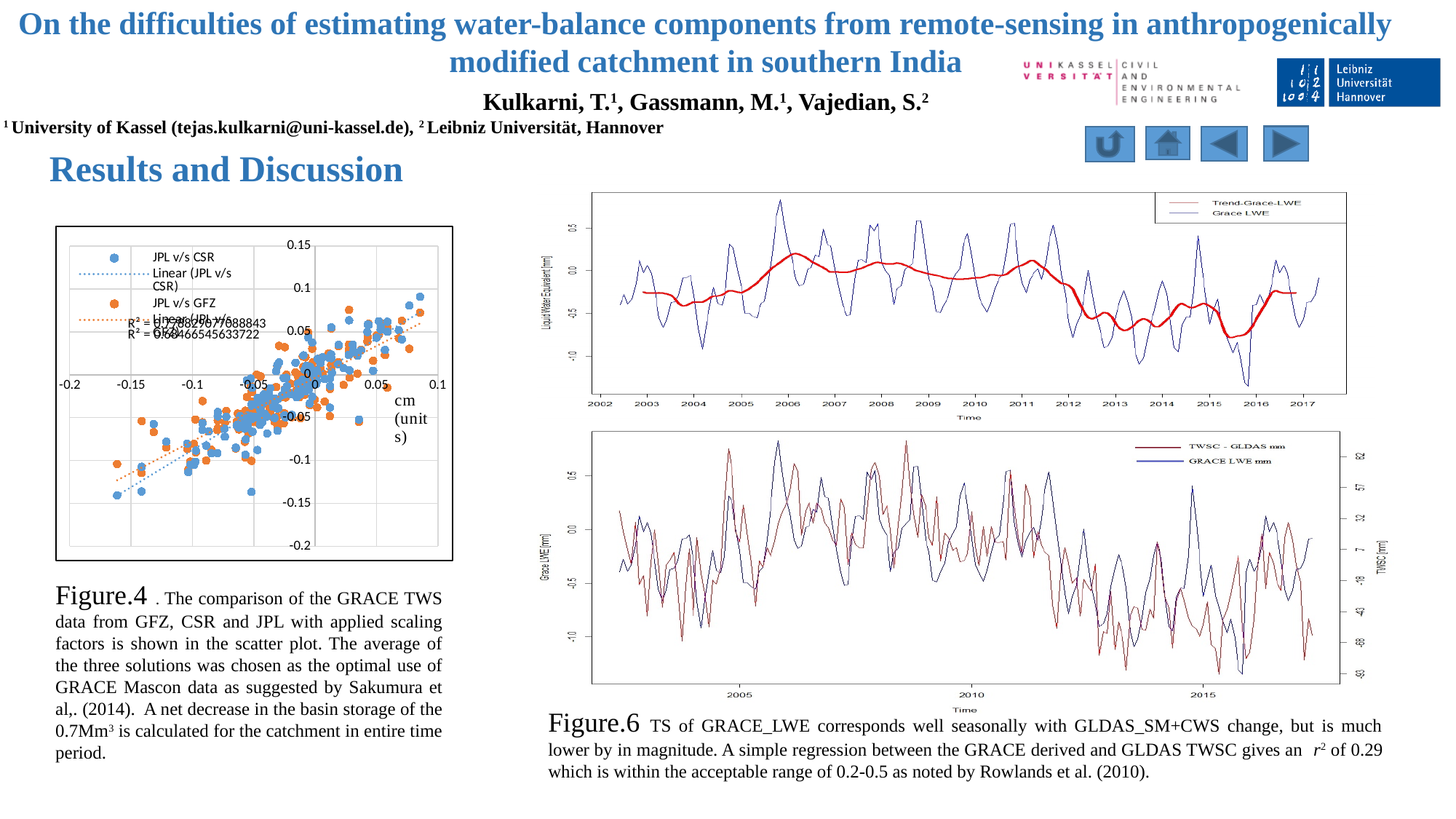
What are the two legend entries of the bottom right chart? TWSC - GLDAS mm and GRACE LWE mm In the top right chart, does the red Trend-Grace-LWE line rise or fall between 2006 and 2015? fall How many series does the legend of the bottom right chart list? 2 In the top right chart, is the lowest value of the Grace LWE series (around 2016) greater or less than -1.0? less In the scatter chart of Figure 4, do the points generally rise or fall as the x value increases? rise What kind of chart is Figure 4 on the left of the slide? scatter chart How many series does the legend of the top right chart list? 2 How many entries does the legend of the scatter chart in Figure 4 list? 4 In the top right chart, what is the first year shown on the Time axis? 2002 What kind of chart is the top right chart (Trend-Grace-LWE / Grace LWE)? line chart In the top right chart, is the highest value of the Grace LWE series (around 2006) greater or less than 0.5? greater What are the two legend entries of the top right chart? Trend-Grace-LWE and Grace LWE